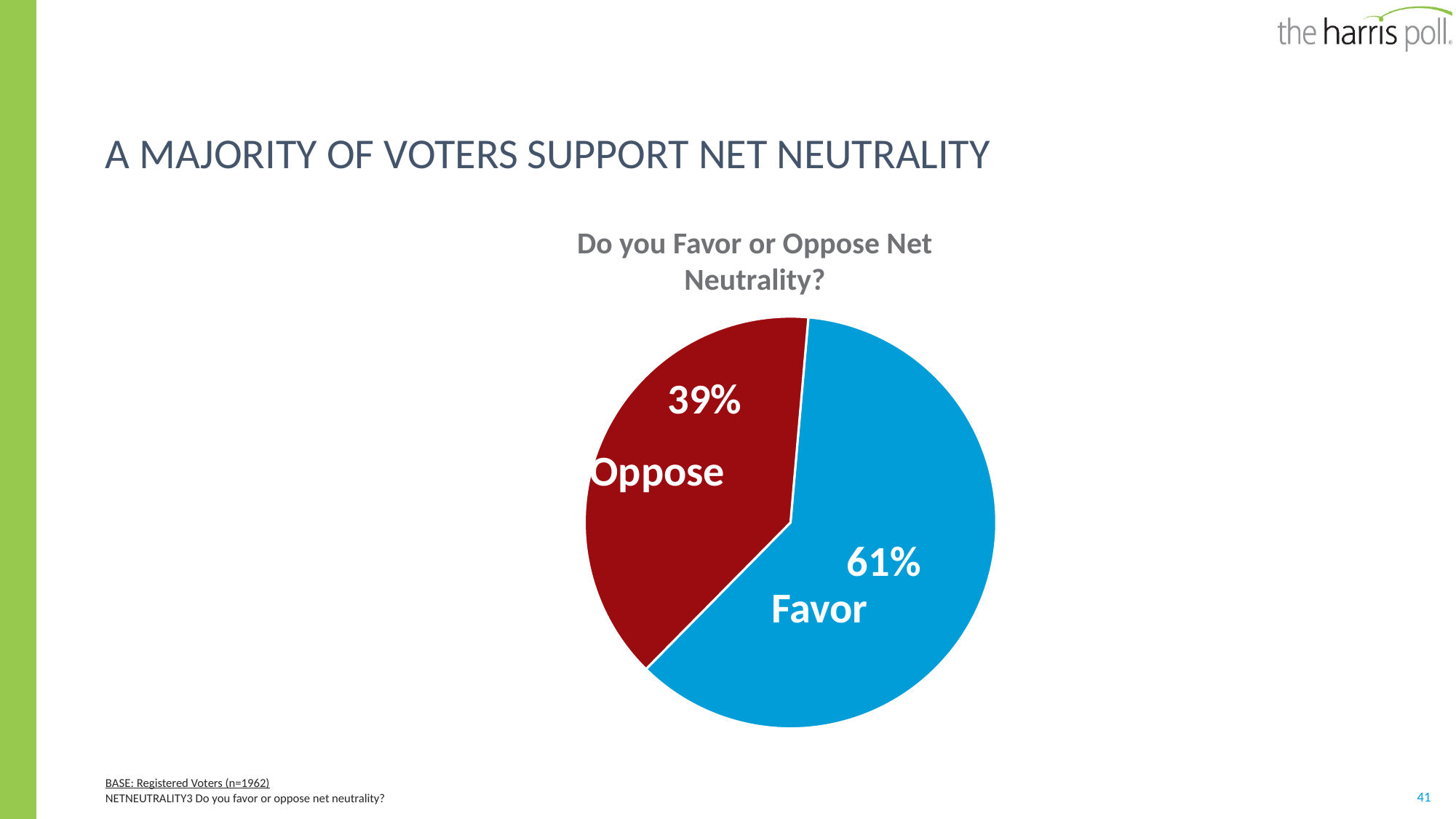
Is the value for Favor greater or less than 50%? greater What is the difference in percentage points between Favor and Oppose? 22 What percentage of voters favor net neutrality? 61% How many slices does the pie chart have? 2 Which slice of the pie is the largest? Favor What is the chart's title? Do you Favor or Oppose Net Neutrality? What share of the pie does the Oppose slice represent? 39% What colour is the Favor slice? Blue Which slice of the pie is the smallest? Oppose What percentage of voters oppose net neutrality? 39% What kind of chart is shown on the slide? Pie chart Which is larger, the Favor slice or the Oppose slice? Favor